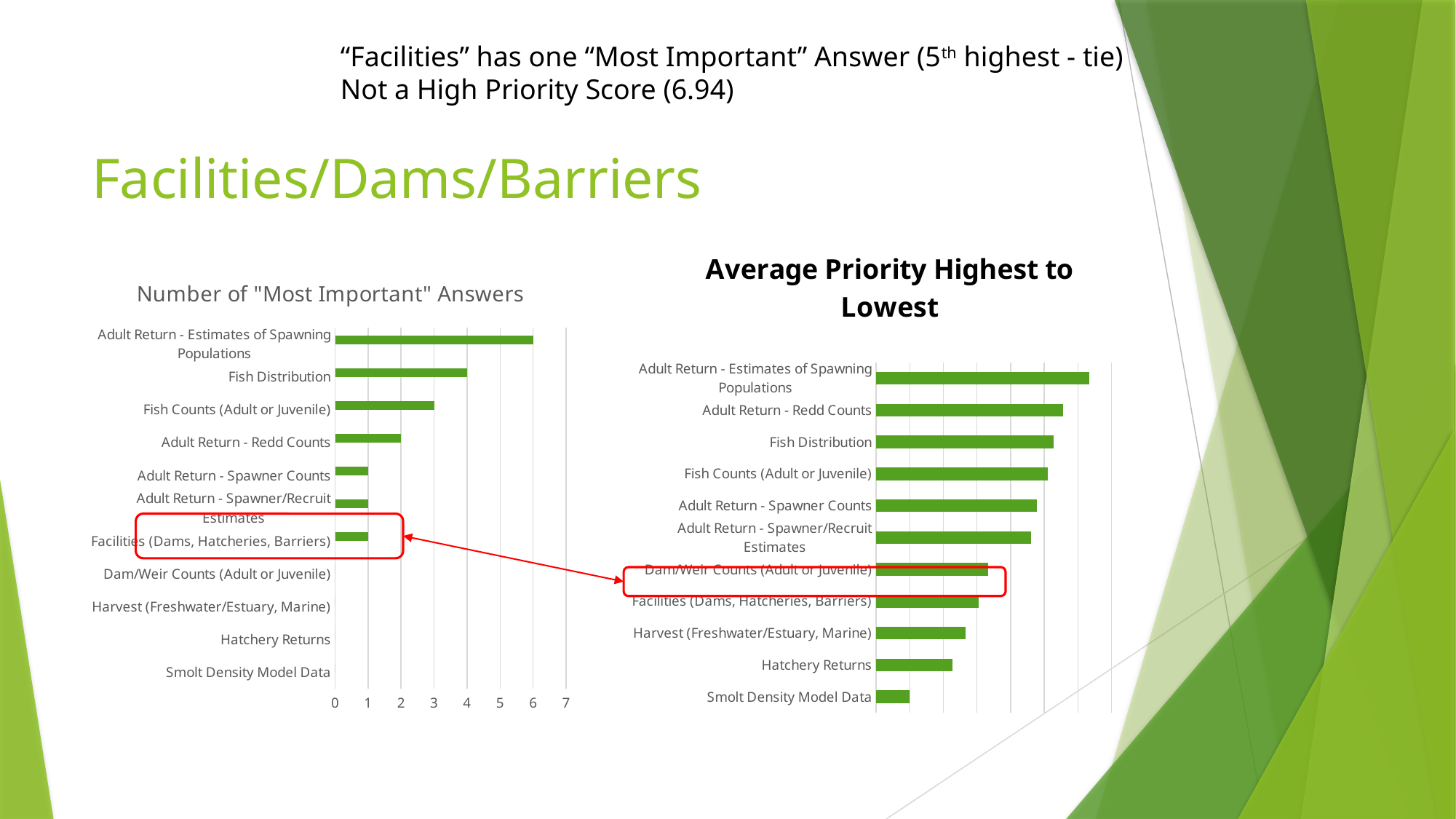
In the "Number of "Most Important" Answers" chart, which category has the highest value? Adult Return - Estimates of Spawning Populations In the "Number of "Most Important" Answers" chart, what is the value for Fish Counts (Adult or Juvenile)? 3 In the "Number of "Most Important" Answers" chart, which is larger: Fish Counts (Adult or Juvenile) or Adult Return - Redd Counts? Fish Counts (Adult or Juvenile) What type of chart is the "Average Priority Highest to Lowest" chart? Bar chart In the "Average Priority Highest to Lowest" chart, which category has the lowest average priority? Smolt Density Model Data In the "Number of "Most Important" Answers" chart, what is the value for Fish Distribution? 4 In the "Average Priority Highest to Lowest" chart, which category has the highest average priority? Adult Return - Estimates of Spawning Populations In the "Number of "Most Important" Answers" chart, how many categories are listed? 11 In the "Number of "Most Important" Answers" chart, how many "Most Important" answers does Adult Return - Estimates of Spawning Populations have? 6 In the "Number of "Most Important" Answers" chart, what is the value for Facilities (Dams, Hatcheries, Barriers)? 1 In the "Number of "Most Important" Answers" chart, what is the difference between Adult Return - Estimates of Spawning Populations and Fish Distribution? 2 In the "Average Priority Highest to Lowest" chart, which is larger: Hatchery Returns or Harvest (Freshwater/Estuary, Marine)? Harvest (Freshwater/Estuary, Marine)